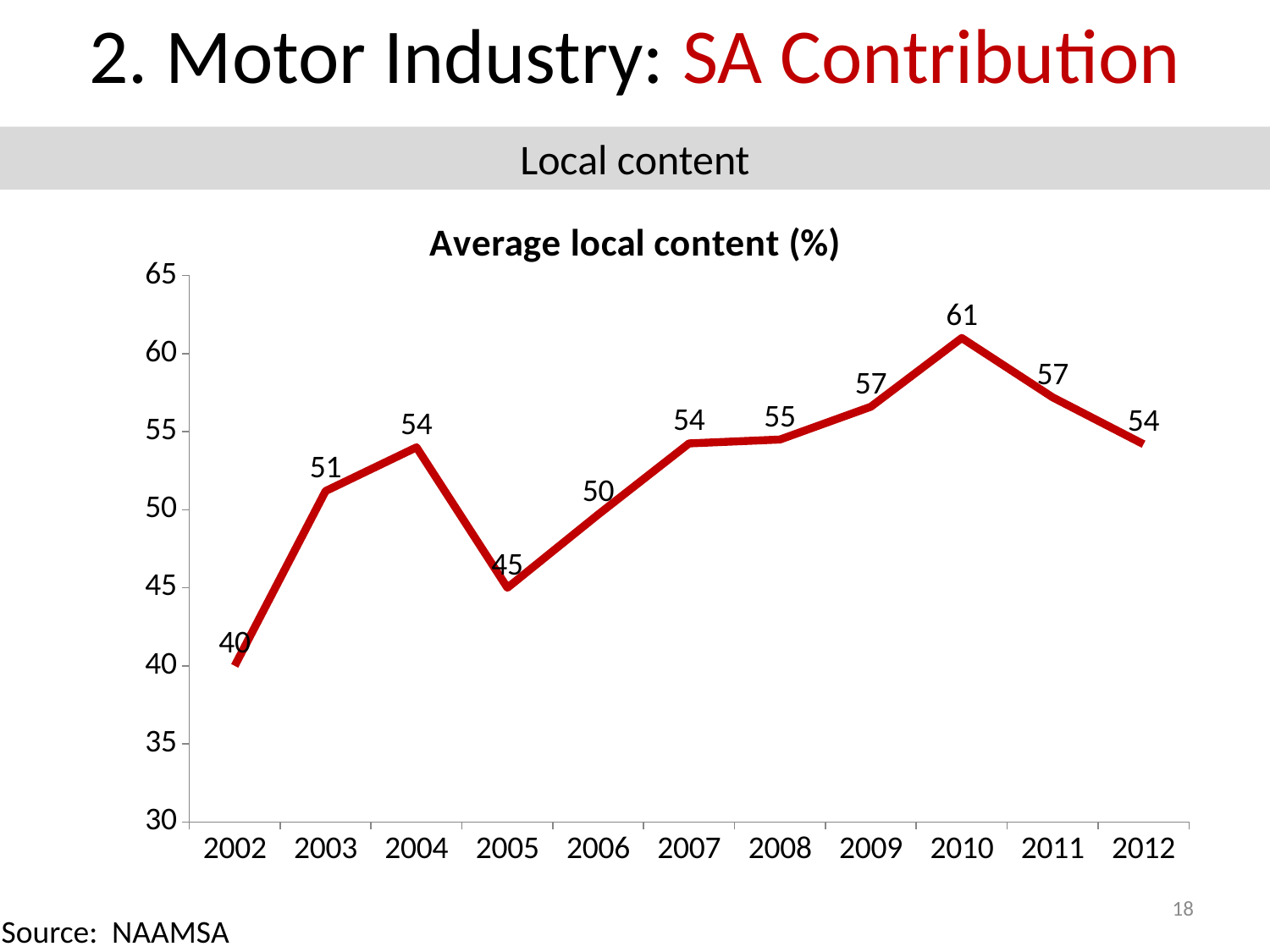
Which year has a higher average local content, 2004 or 2005? 2004 Which year has the lowest average local content? 2002 What is the average local content (%) for 2005? 45 Is the value for 2009 greater or less than 55? greater What is the title of the chart? Average local content (%) What is the average local content (%) for 2010? 61 What is the difference between the average local content in 2010 and 2012? 7 How many years are plotted on the chart? 11 Does the average local content rise or fall from 2010 to 2012? Fall Which year has the highest average local content? 2010 What kind of chart is shown on the slide? Line chart What is the average local content (%) for 2002? 40